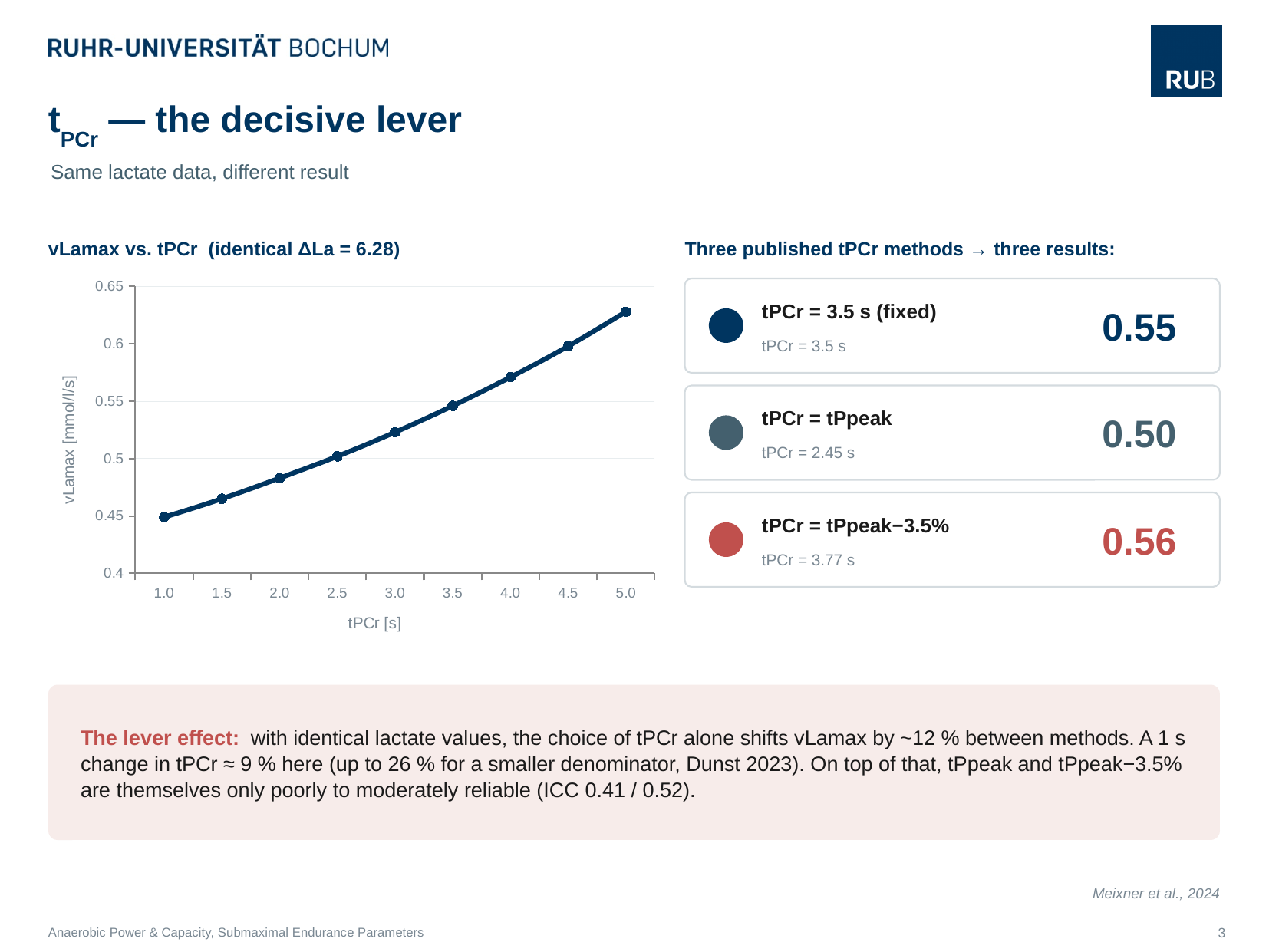
At which tPCr value is vLamax lowest? 1.0 Which has the larger vLamax value: tPCr = 2.0 or tPCr = 4.0? tPCr = 4.0 Is the vLamax value at tPCr = 5.0 greater or less than 0.6? greater What kind of chart is shown under the title "vLamax vs. tPCr"? line chart How many data points are plotted on the vLamax vs. tPCr line? 9 Does vLamax rise or fall as tPCr increases along the x axis? rise At which tPCr value is vLamax highest? 5.0 What is the label of the y axis of the chart? vLamax [mmol/l/s] Is the vLamax value at tPCr = 3.0 greater or less than 0.5? greater What is the label of the x axis of the chart? tPCr [s] Is the vLamax value at tPCr = 2.0 greater or less than 0.5? less